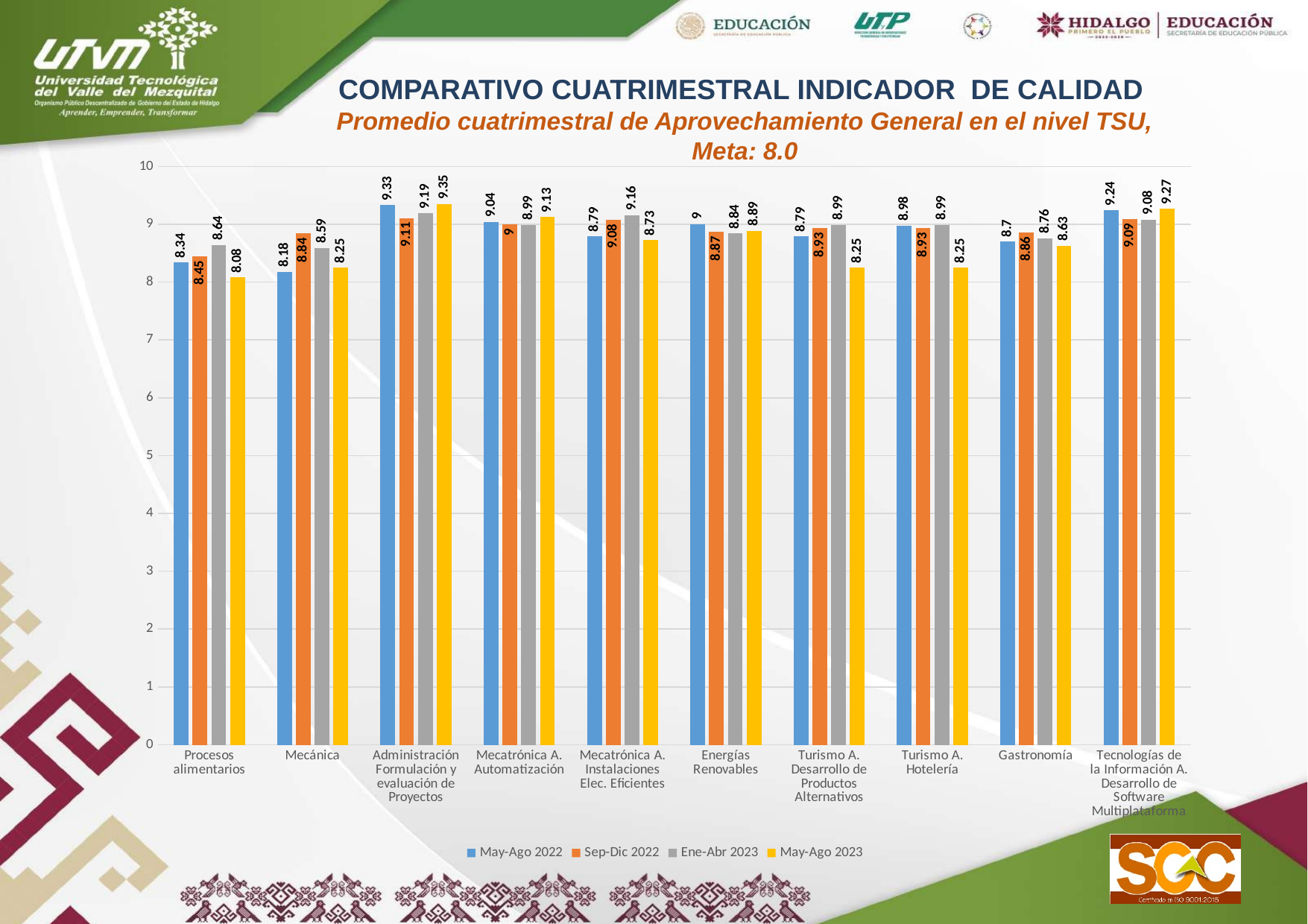
What is the value for Gastronomía in the May-Ago 2022 series? 8.7 What kind of chart is shown on the slide? Bar chart For Mecánica, which is larger: the Sep-Dic 2022 value or the May-Ago 2022 value? Sep-Dic 2022 What is the value for Procesos alimentarios in the May-Ago 2023 series? 8.08 Which category has the highest value in the May-Ago 2023 series? Administración Formulación y evaluación de Proyectos Which category has the lowest value in the May-Ago 2022 series? Mecánica What is the value for Mecánica in the Sep-Dic 2022 series? 8.84 Is the Ene-Abr 2023 value for Turismo A. Hotelería greater or less than 8? greater What is the target (Meta) stated in the chart subtitle? 8.0 How many categories are shown on the x axis? 10 What is the difference between the May-Ago 2023 values for Administración Formulación y evaluación de Proyectos and Procesos alimentarios? 1.27 How many series does the legend list? 4